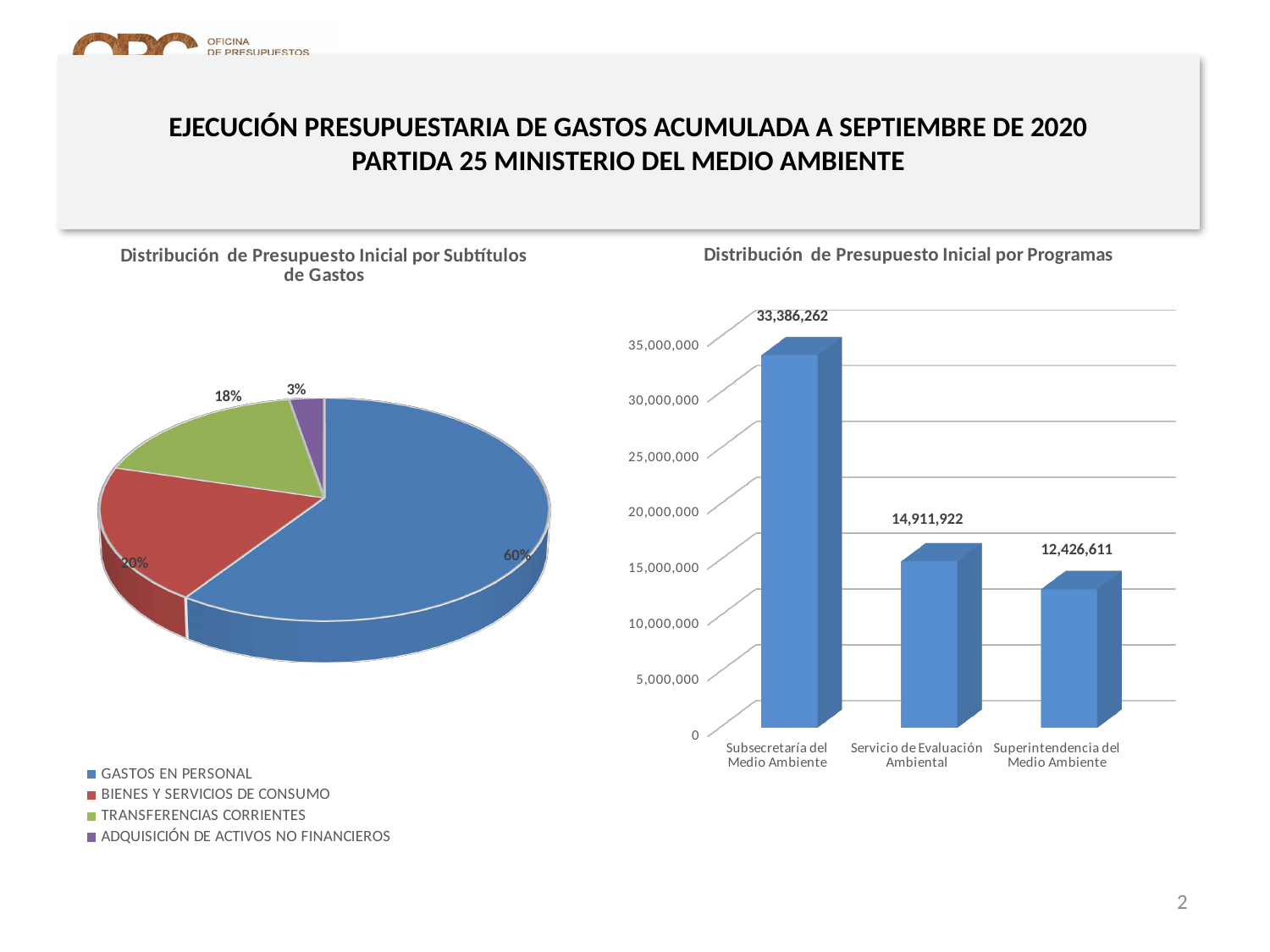
In the 'Distribución de Presupuesto Inicial por Subtítulos de Gastos' pie chart, what share does GASTOS EN PERSONAL have? 60% In the 'Distribución de Presupuesto Inicial por Programas' chart, how many programs are shown? 3 In the 'Distribución de Presupuesto Inicial por Programas' chart, which program has the lowest value? Superintendencia del Medio Ambiente In the 'Distribución de Presupuesto Inicial por Programas' chart, what is the value for Servicio de Evaluación Ambiental? 14,911,922 How many categories does the legend of the 'Distribución de Presupuesto Inicial por Subtítulos de Gastos' pie chart list? 4 In the 'Distribución de Presupuesto Inicial por Programas' chart, what is the value for Superintendencia del Medio Ambiente? 12,426,611 What kind of chart is 'Distribución de Presupuesto Inicial por Programas'? Bar chart In the 'Distribución de Presupuesto Inicial por Programas' chart, what is the value for Subsecretaría del Medio Ambiente? 33,386,262 In the 'Distribución de Presupuesto Inicial por Programas' chart, what is the difference between Subsecretaría del Medio Ambiente and Servicio de Evaluación Ambiental? 18,474,340 In the 'Distribución de Presupuesto Inicial por Programas' chart, which program has the highest value? Subsecretaría del Medio Ambiente In the 'Distribución de Presupuesto Inicial por Subtítulos de Gastos' pie chart, what share does TRANSFERENCIAS CORRIENTES have? 18% In the 'Distribución de Presupuesto Inicial por Subtítulos de Gastos' pie chart, which category has the smallest share? ADQUISICIÓN DE ACTIVOS NO FINANCIEROS